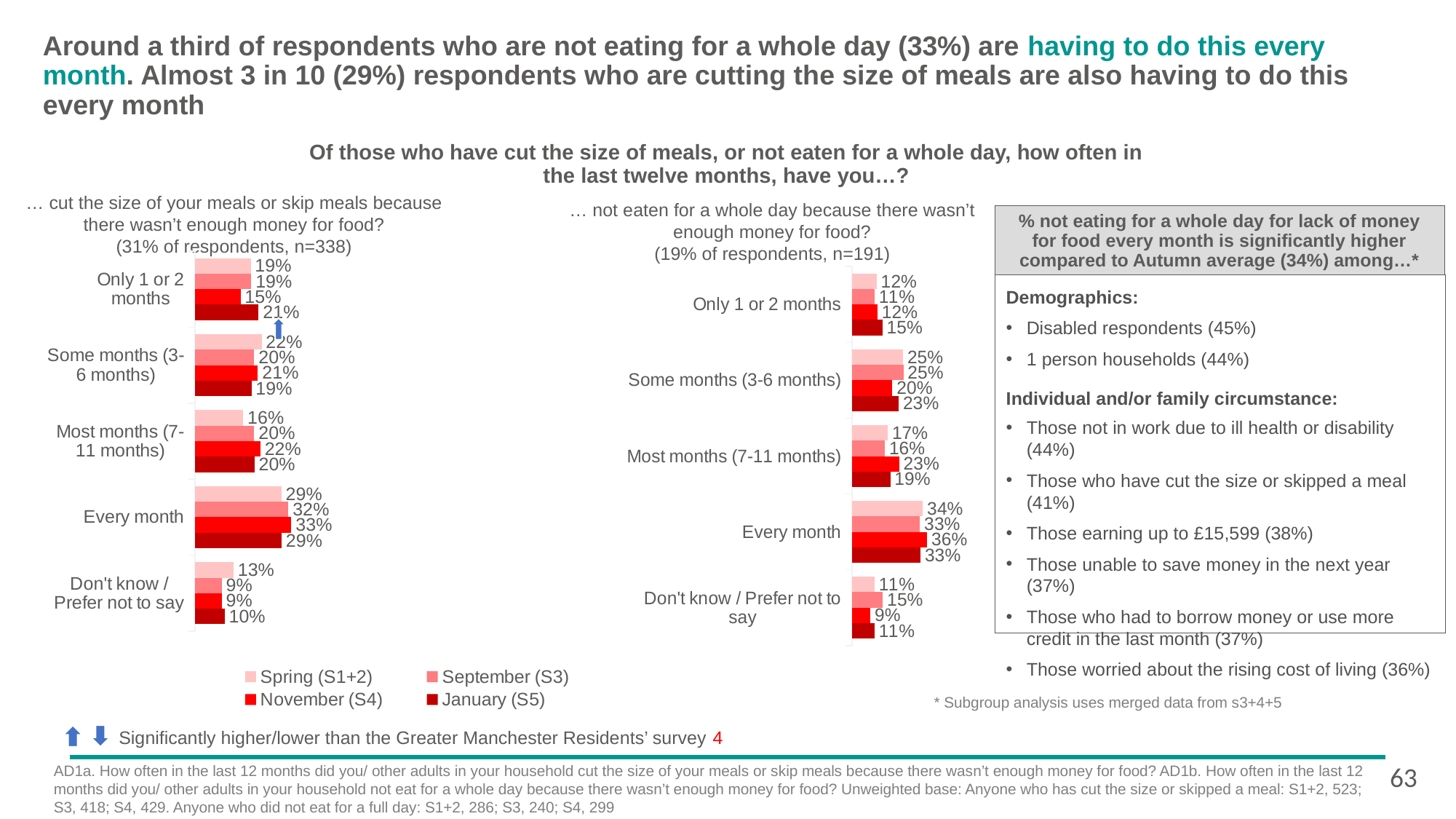
In the right chart (not eaten for a whole day), what is the November (S4) value for Every month? 36% In the right chart (not eaten for a whole day), what is the January (S5) value for Only 1 or 2 months? 15% In the left chart (cut the size of your meals or skip meals), what is the difference between the November (S4) and January (S5) values for Every month? 4 percentage points How many series does the legend list? 4 What kind of chart is used for the left chart (cut the size of your meals or skip meals)? Bar chart How many categories are shown in the right chart (not eaten for a whole day)? 5 In the right chart (not eaten for a whole day), which category has the highest Spring (S1+2) value? Every month In the left chart (cut the size of your meals or skip meals), what is the Spring (S1+2) value for Don't know / Prefer not to say? 13% In the left chart (cut the size of your meals or skip meals), what is the November (S4) value for Every month? 33% In the left chart (cut the size of your meals or skip meals), which category has the lowest September (S3) value? Don't know / Prefer not to say Which legend entry is shown in the darkest red colour? January (S5) In the right chart (not eaten for a whole day), which is larger for Most months (7-11 months): the November (S4) value or the September (S3) value? November (S4)